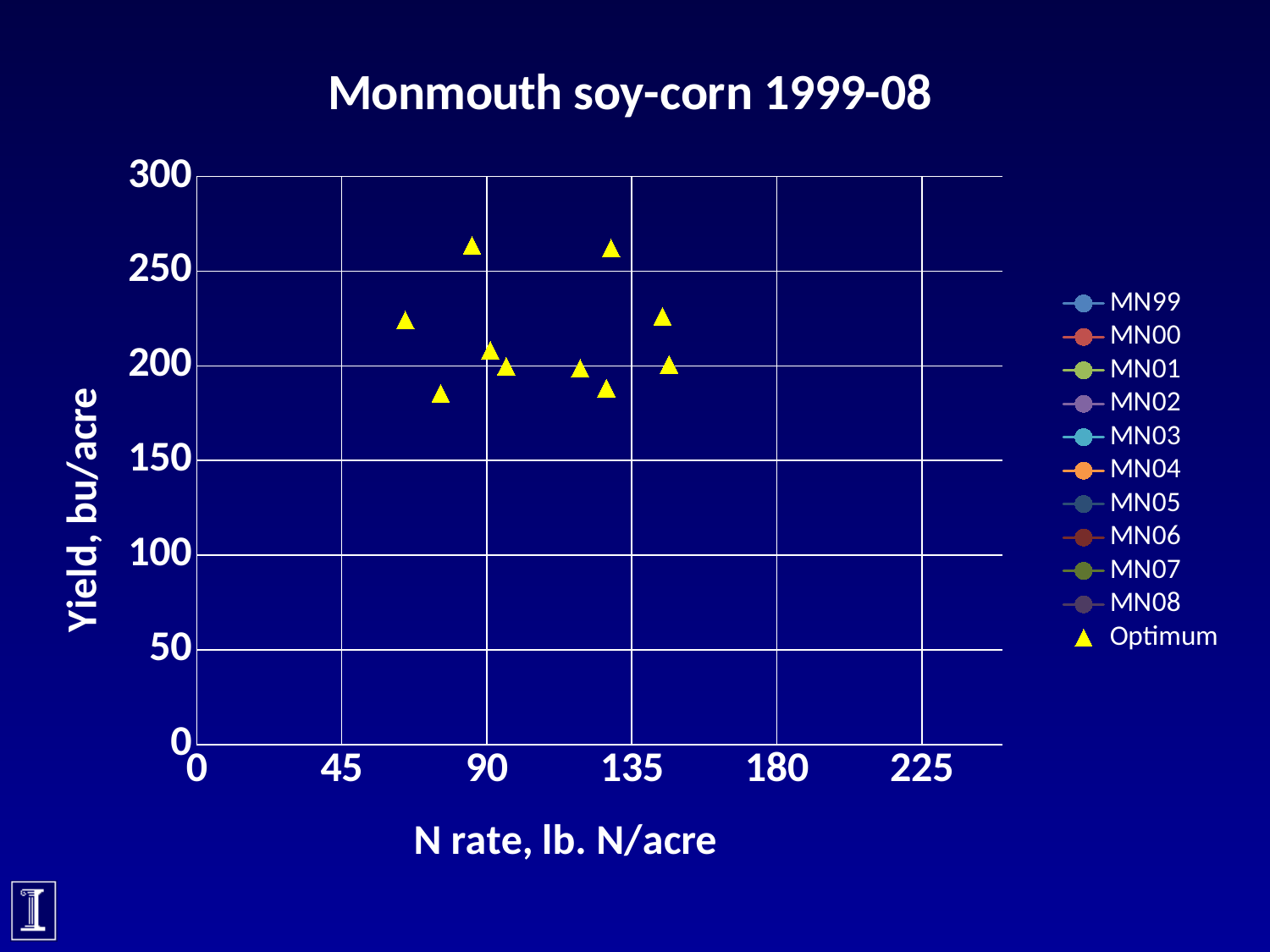
Is the highest Optimum yield plotted greater or less than 250 bu/acre? greater How many entries does the legend list? 11 What kind of chart is shown on the slide? scatter chart Are all of the Optimum points plotted at N rates greater or less than 180 lb. N/acre? less Is the lowest Optimum yield plotted greater or less than 200 bu/acre? less How many Optimum points are plotted on the chart? 10 What is the title of the chart? Monmouth soy-corn 1999-08 How many Optimum points are plotted above 250 bu/acre? 2 What is the label of the y axis? Yield, bu/acre